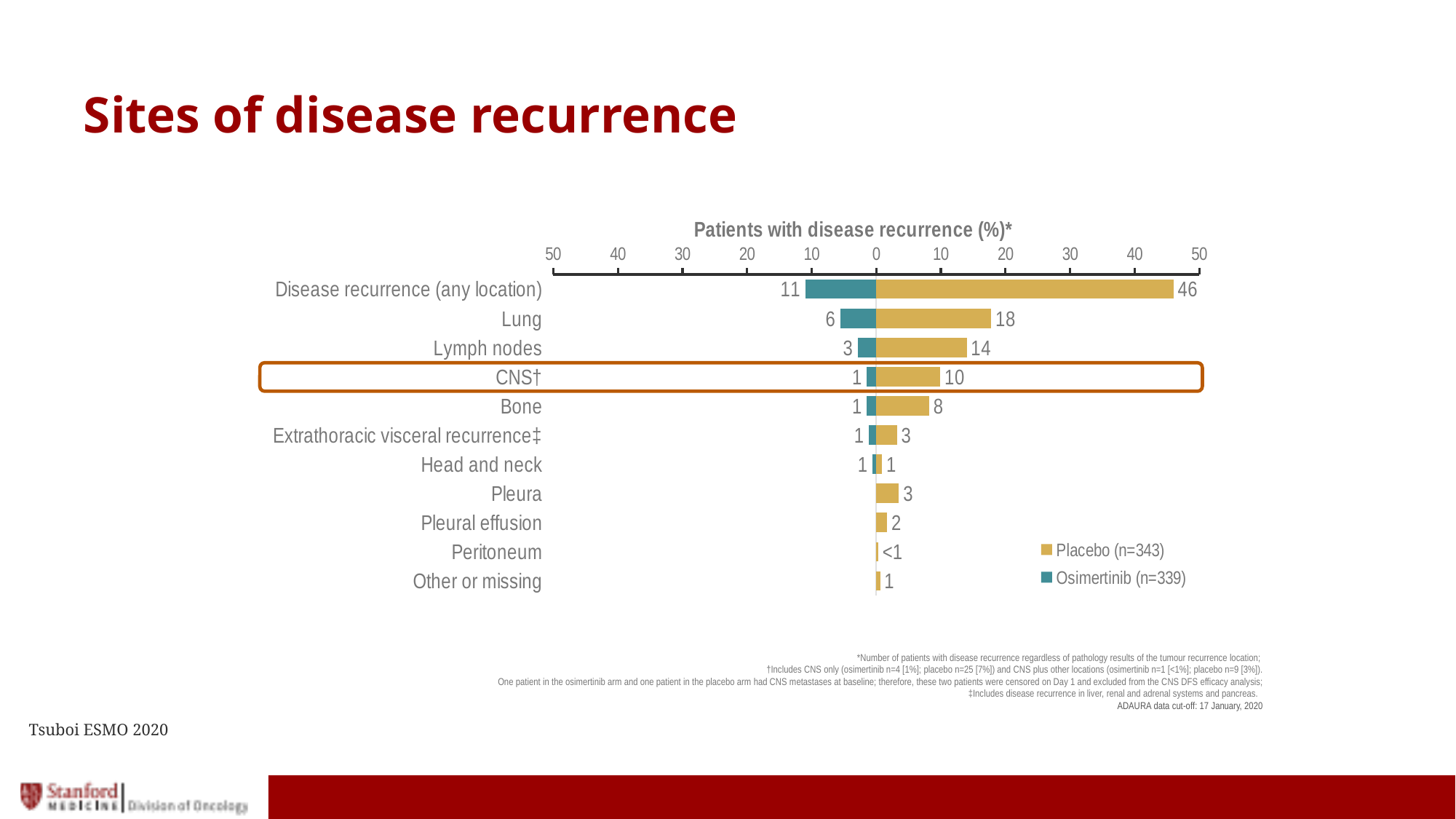
What is the Placebo value for Lung? 18 What kind of chart is shown on the slide? Bar chart What is the Osimertinib value for Disease recurrence (any location)? 11 What is the Osimertinib value for Lymph nodes? 3 What is the title of the chart's horizontal axis? Patients with disease recurrence (%)* Which is larger, the Placebo value for Bone or the Placebo value for Pleura? Bone What is the difference between the Placebo values for Lymph nodes and Bone? 6 How many series does the legend list? 2 What is the difference between the Placebo and Osimertinib values for Lung? 12 How many categories are shown on the y axis of the chart? 11 Which category has the highest Placebo value? Disease recurrence (any location) What is the Placebo value for CNS†? 10